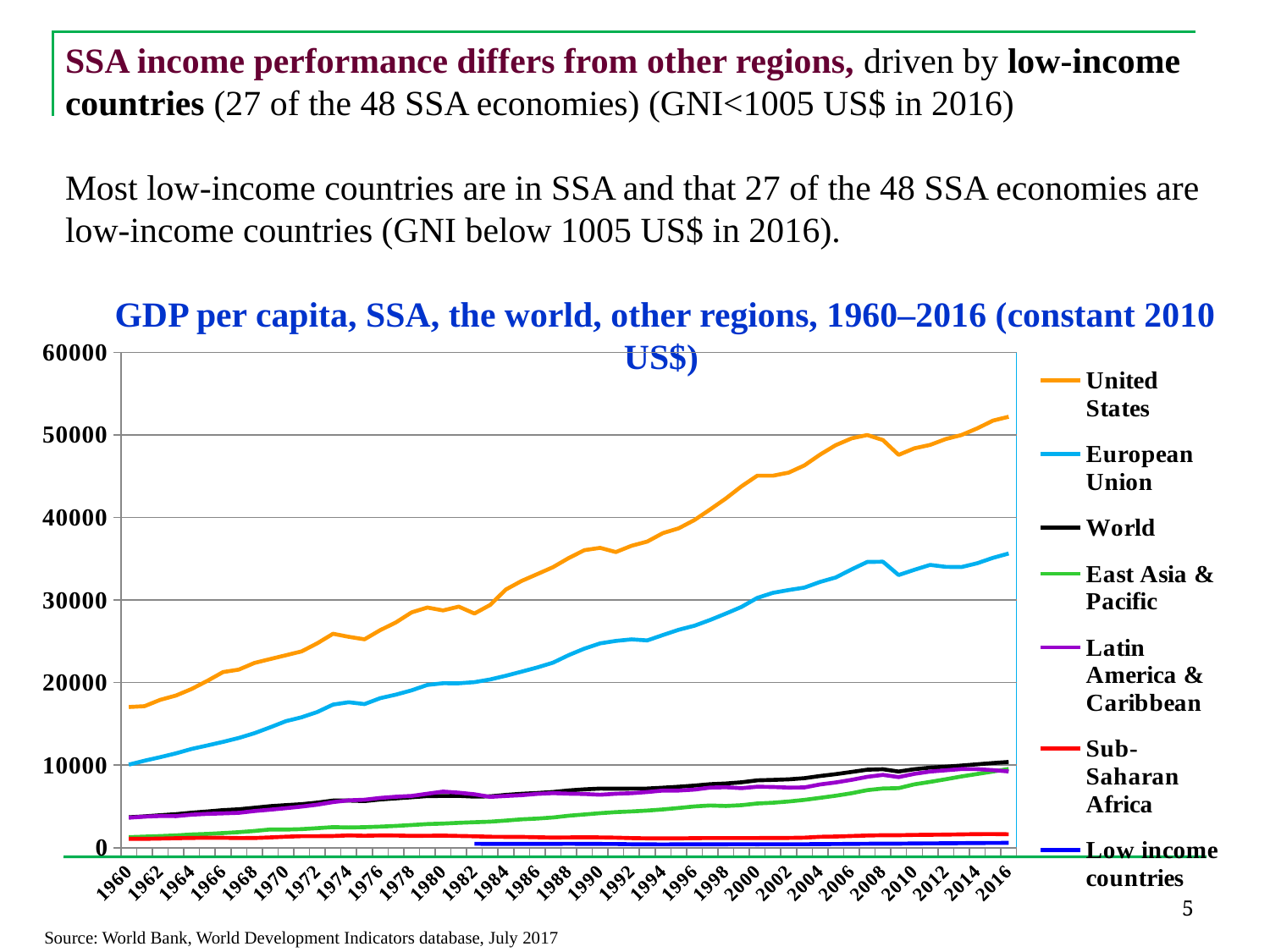
Is the value for the United States in 2016 greater or less than 50000? greater Is the value for the European Union in 2016 greater or less than 40000? less Which is larger in 2016, the European Union or the World? European Union Which series has the highest GDP per capita in 2016? United States Is the value for Sub-Saharan Africa in 2016 greater or less than 10000? less How many series does the chart's legend list? 7 What is the title of the chart? GDP per capita, SSA, the world, other regions, 1960–2016 (constant 2010 US$) Which series is drawn in red? Sub-Saharan Africa Does the United States series rise or fall overall from 1960 to 2016? Rise What kind of chart is shown on the slide? Line chart Which series has the lowest GDP per capita in 2016? Low income countries